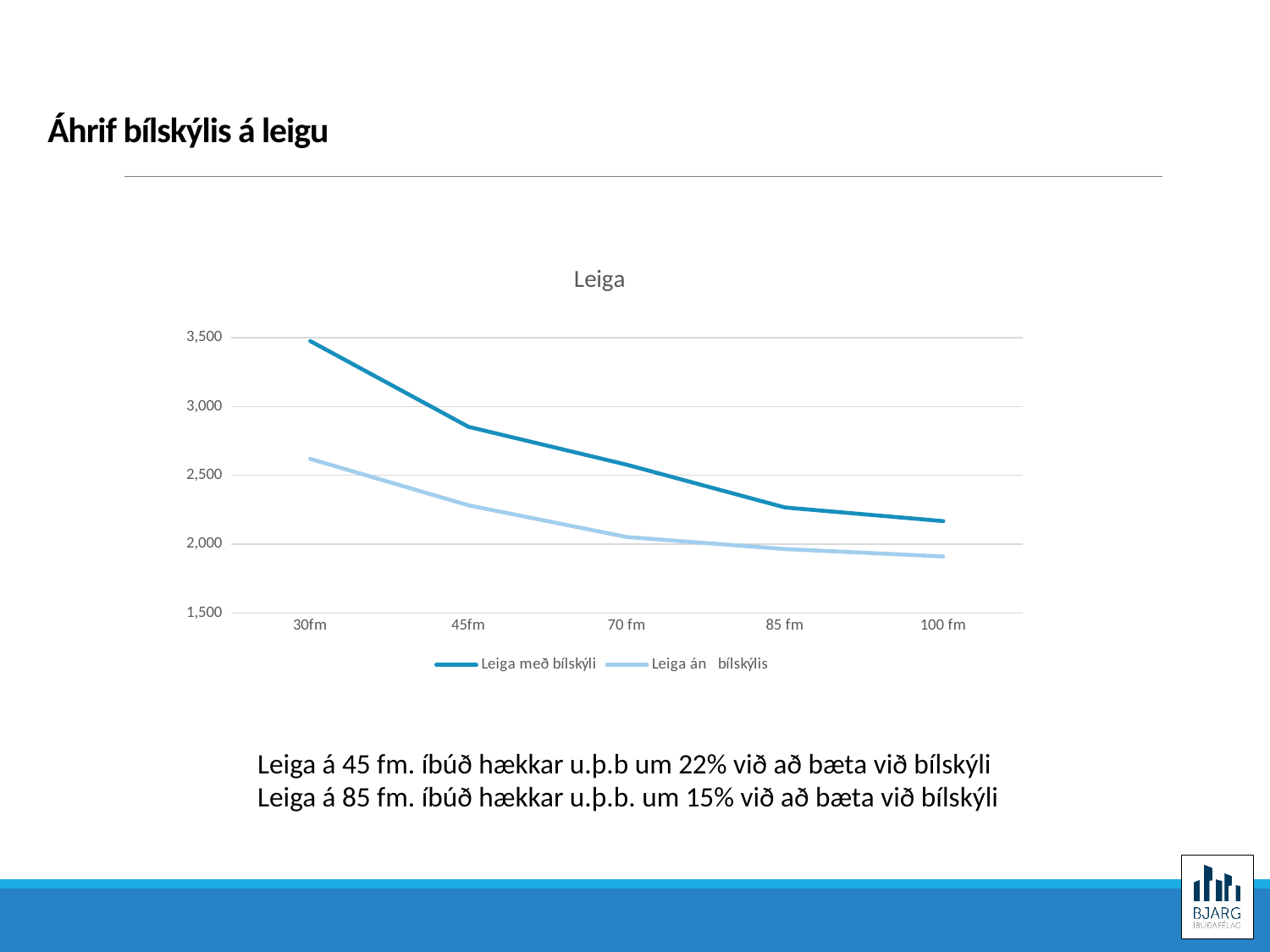
Do the values for Leiga með bílskýli rise or fall as apartment size increases along the x axis? fall Is the value for Leiga með bílskýli at 85 fm greater or less than 2,000? greater At 45fm, which series has the larger value, Leiga með bílskýli or Leiga án bílskýlis? Leiga með bílskýli What kind of chart is shown on the slide? line chart At which category is the value for Leiga með bílskýli highest? 30fm What is the title of the chart? Leiga How many series does the legend list? 2 At which category is the value for Leiga án bílskýlis lowest? 100 fm Is the value for Leiga með bílskýli at 30fm greater or less than 3,000? greater Is the value for Leiga án bílskýlis at 30fm greater or less than 3,000? less How many categories are shown on the x axis? 5 Which series is drawn with the darker blue line? Leiga með bílskýli